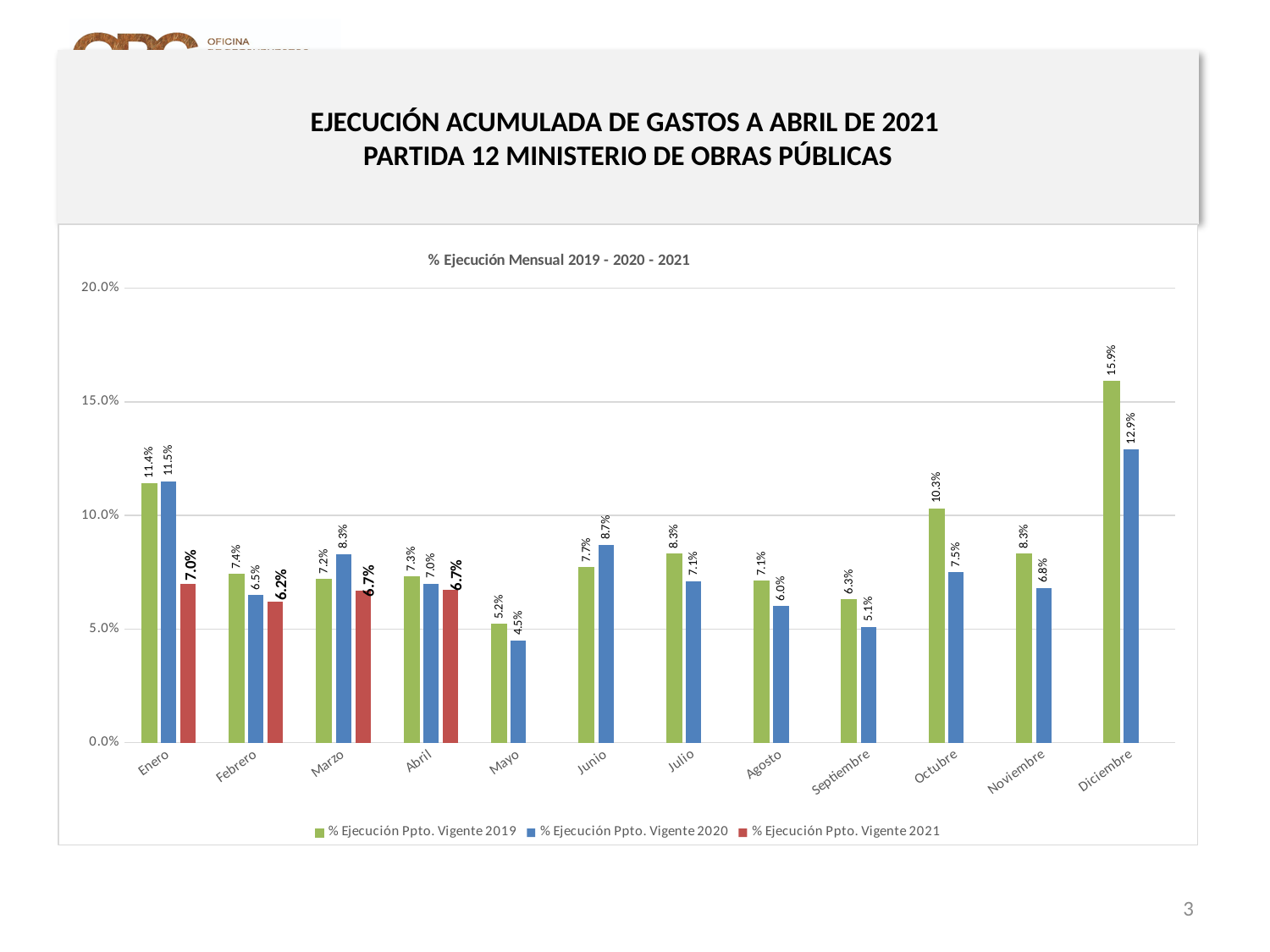
What is the value for % Ejecución Ppto. Vigente 2019 in Diciembre? 15.9% How many months are shown on the x axis? 12 Which month has the lowest value for % Ejecución Ppto. Vigente 2019? Mayo Which is larger in Junio: the 2019 value or the 2020 value? 2020 How many series does the legend list? 3 What type of chart is shown on the slide? bar chart Which month has the highest value for % Ejecución Ppto. Vigente 2020? Diciembre What is the value for % Ejecución Ppto. Vigente 2020 in Octubre? 7.5% What is the value for % Ejecución Ppto. Vigente 2021 in Marzo? 6.7% What is the title of the chart? % Ejecución Mensual 2019 - 2020 - 2021 Is the value for % Ejecución Ppto. Vigente 2019 in Octubre greater or less than 10.0%? greater What is the difference between the 2019 and 2020 values in Diciembre? 3.0%